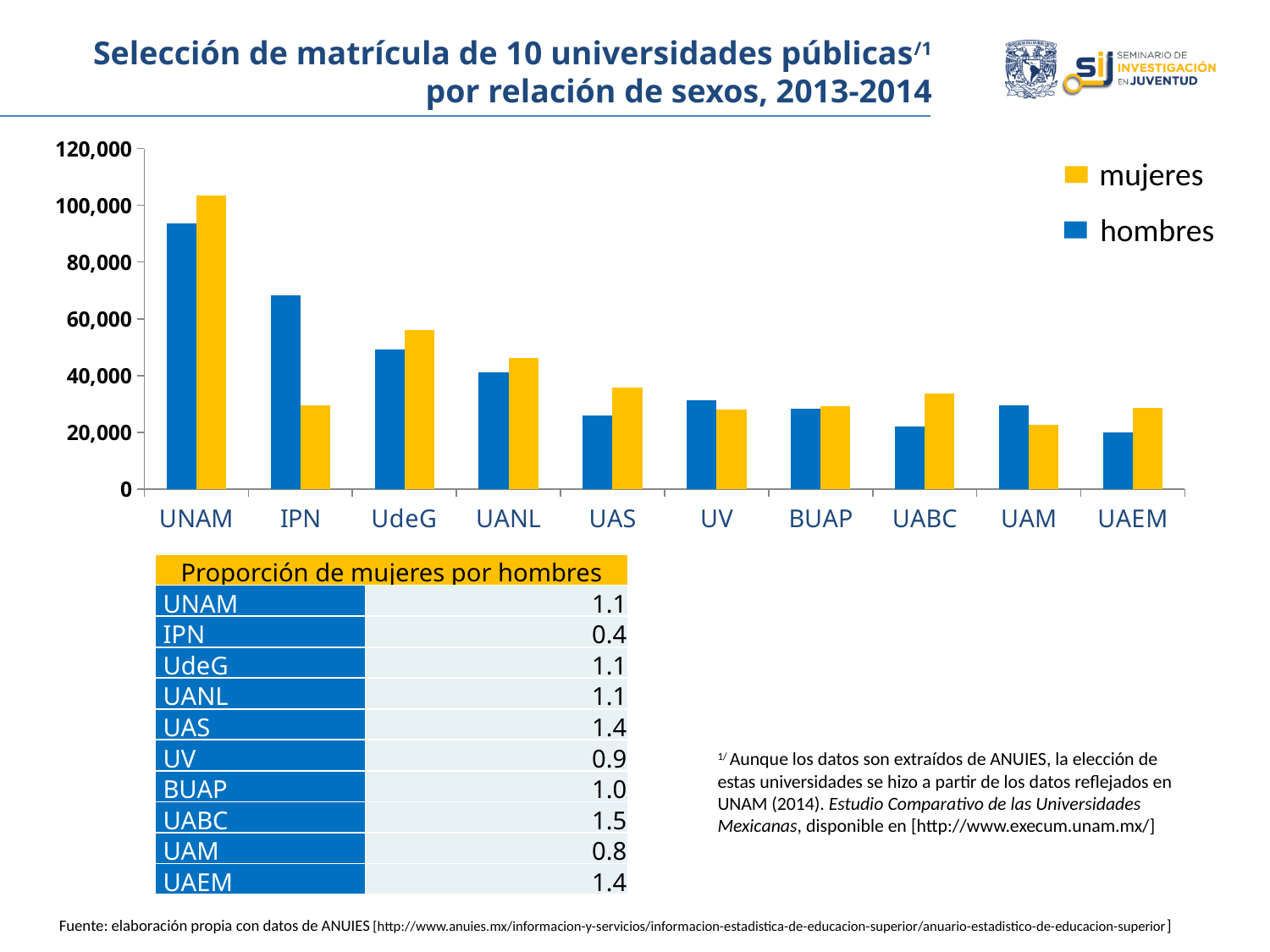
Which university has the highest value for mujeres? UNAM Which university has the highest value for hombres? UNAM For UAS, which is larger, hombres or mujeres? mujeres How many series does the chart legend list? 2 Is the value for mujeres at UABC greater or less than 20,000? greater Which colour represents mujeres in the chart? yellow For IPN, which is larger, hombres or mujeres? hombres What kind of chart is shown on the slide? bar chart Is the value for hombres at UNAM greater or less than 80,000? greater How many universities are shown on the x axis of the chart? 10 Is the value for hombres at IPN greater or less than 60,000? greater Which university has the lowest value for mujeres? UAM